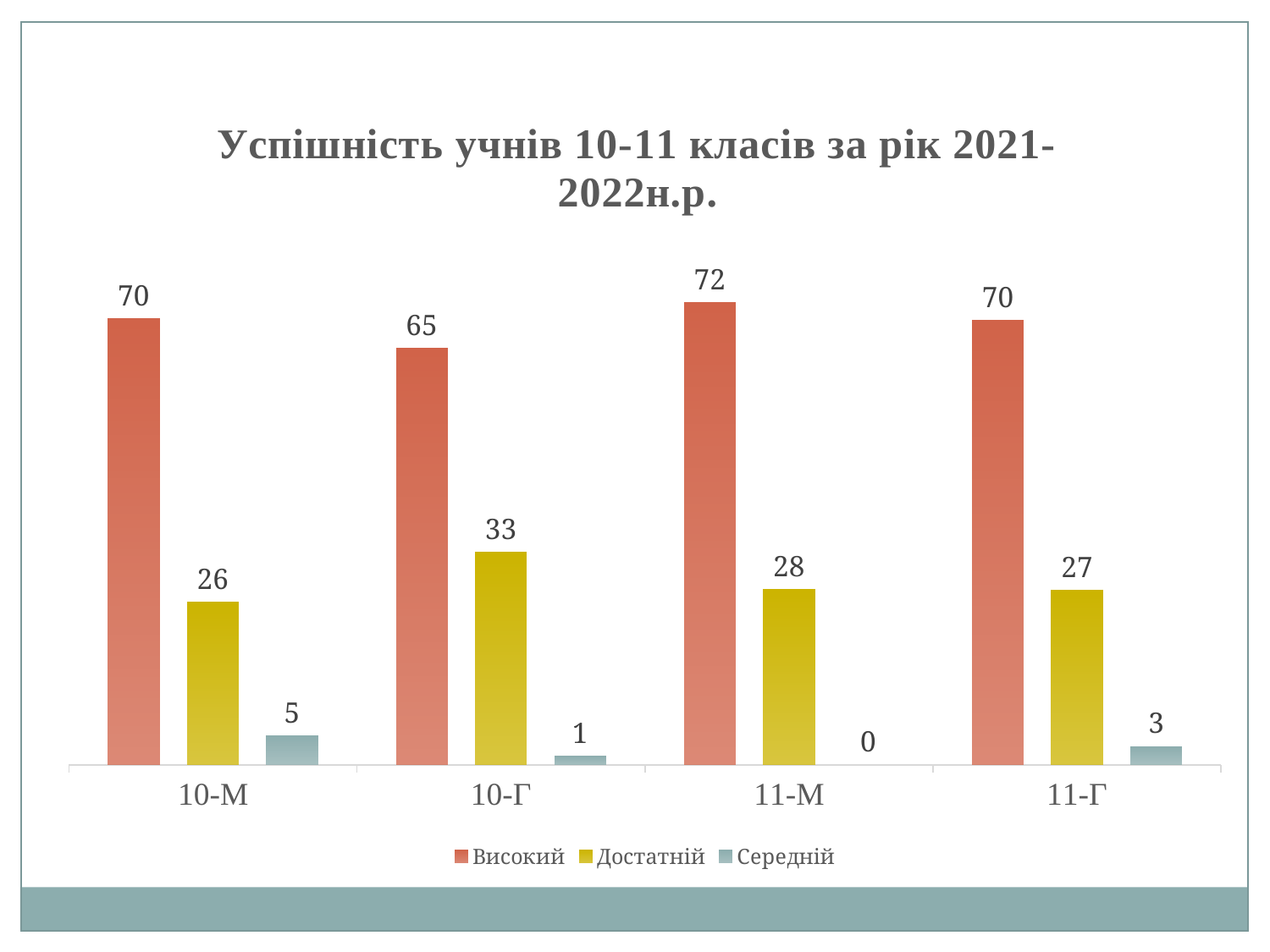
What kind of chart is this? bar chart What is the difference between the Високий values for 11-М and 10-Г? 7 What is the value of Достатній for 10-Г? 33 What is the title of the chart? Успішність учнів 10-11 класів за рік 2021-2022н.р. Which category has the highest Високий value? 11-М What is the value of Високий for 10-М? 70 How many categories are shown on the x axis? 4 Which category has the lowest Достатній value? 10-М Which is larger: Достатній for 11-М or Достатній for 11-Г? 11-М How many series does the legend list? 3 What is the value of Середній for 11-М? 0 What is the difference between the Середній values for 10-М and 11-Г? 2